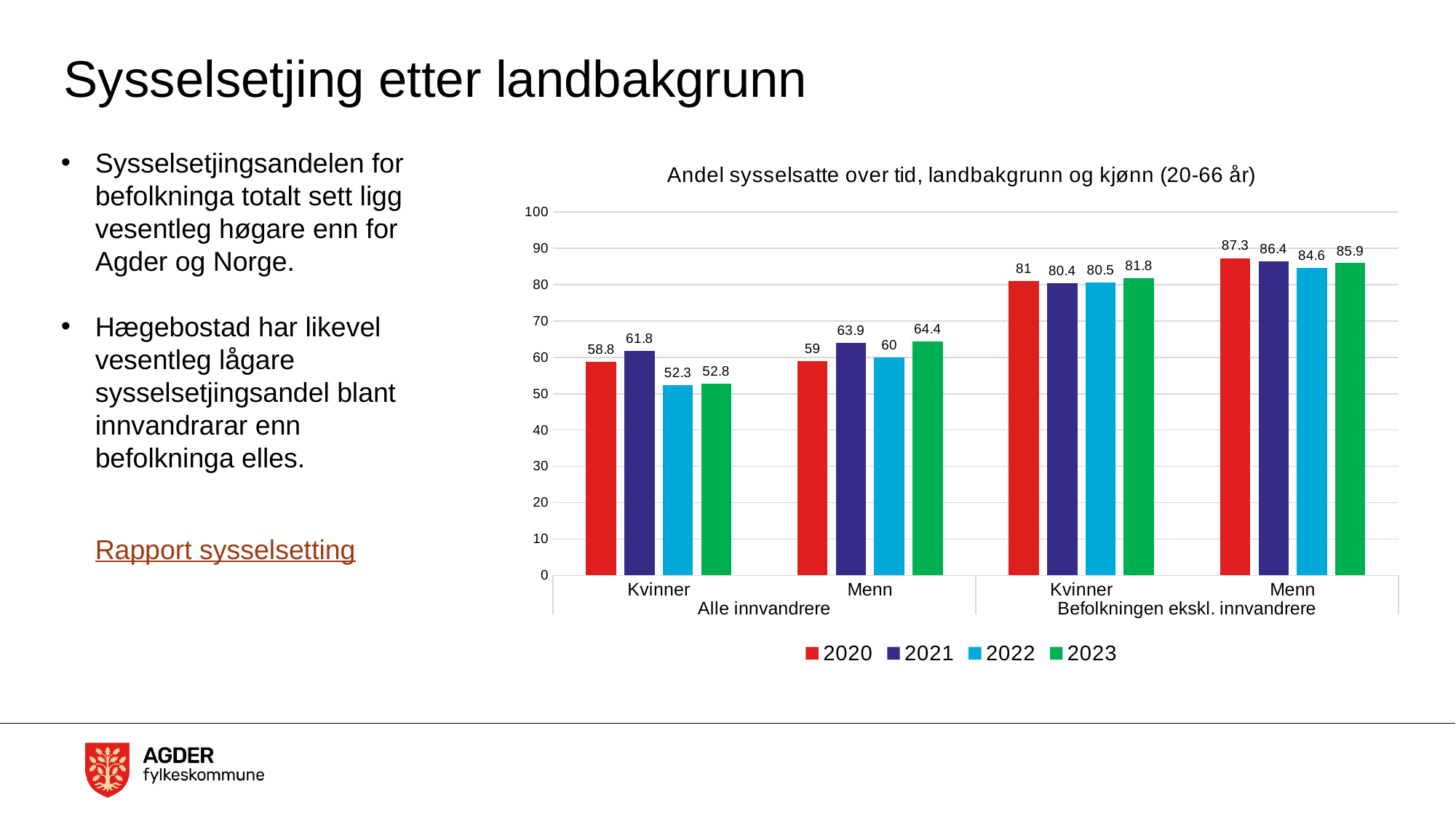
What is the 2023 value for Menn in the Befolkningen ekskl. innvandrere group? 85.9 Which colour represents 2023 in the legend? Green What is the 2020 value for Kvinner in the Alle innvandrere group? 58.8 What is the title of the chart? Andel sysselsatte over tid, landbakgrunn og kjønn (20-66 år) What kind of chart is shown on the slide? Bar chart How many series does the legend list? 4 Which year has the highest value for Kvinner in the Alle innvandrere group? 2021 Which is larger: the 2023 value for Kvinner in Befolkningen ekskl. innvandrere or the 2023 value for Menn in Alle innvandrere? Kvinner in Befolkningen ekskl. innvandrere (81.8) What is the difference between the 2021 and 2022 values for Kvinner in the Alle innvandrere group? 9.5 What is the 2022 value for Menn in the Alle innvandrere group? 60 Which year has the lowest value for Menn in the Befolkningen ekskl. innvandrere group? 2022 How many category groups (gender/background combinations) are shown on the x axis? 4